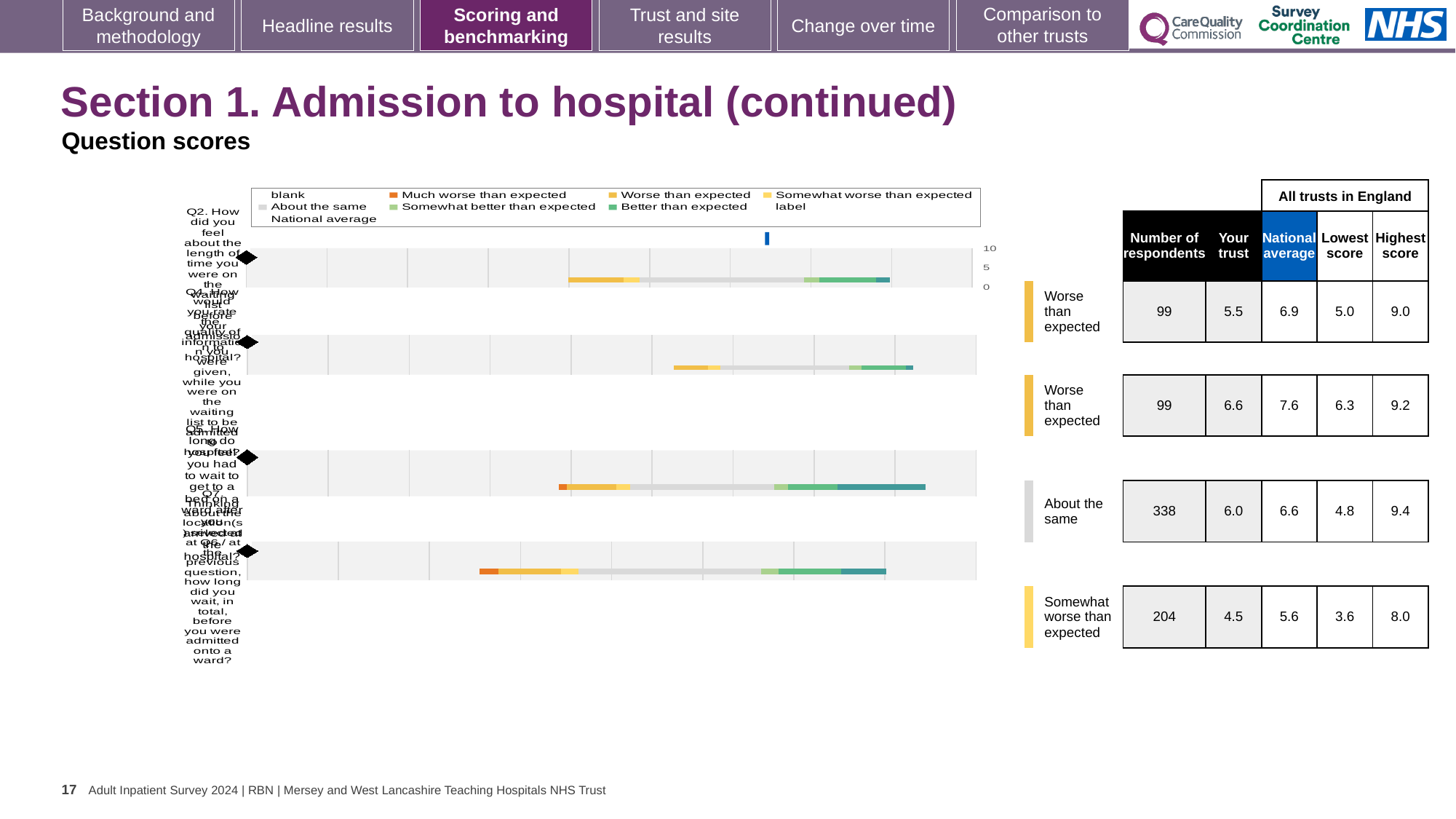
Which chart row has the highest 'Your trust' score in the table: the first, second, third or fourth? second For the second chart row, what benchmark category is shown beside the table? Worse than expected What is the maximum value shown on the chart's score axis? 10 For the top chart row, what is the national average score shown in the table? 6.9 In the chart legend, which colour represents 'Much worse than expected'? orange For the third chart row, how many respondents are shown in the table? 338 What kind of chart is used to show the question scores on this slide? bar chart How many question bars are plotted in the chart area? 4 For the bottom chart row, what is the highest score across all trusts in England? 8.0 For the top chart row, what is the 'Your trust' score shown in the table? 5.5 For the third chart row, is the 'Your trust' score (6.0) larger or smaller than the national average (6.6)? smaller For the bottom chart row, what is the difference between the national average (5.6) and the 'Your trust' score (4.5)? 1.1